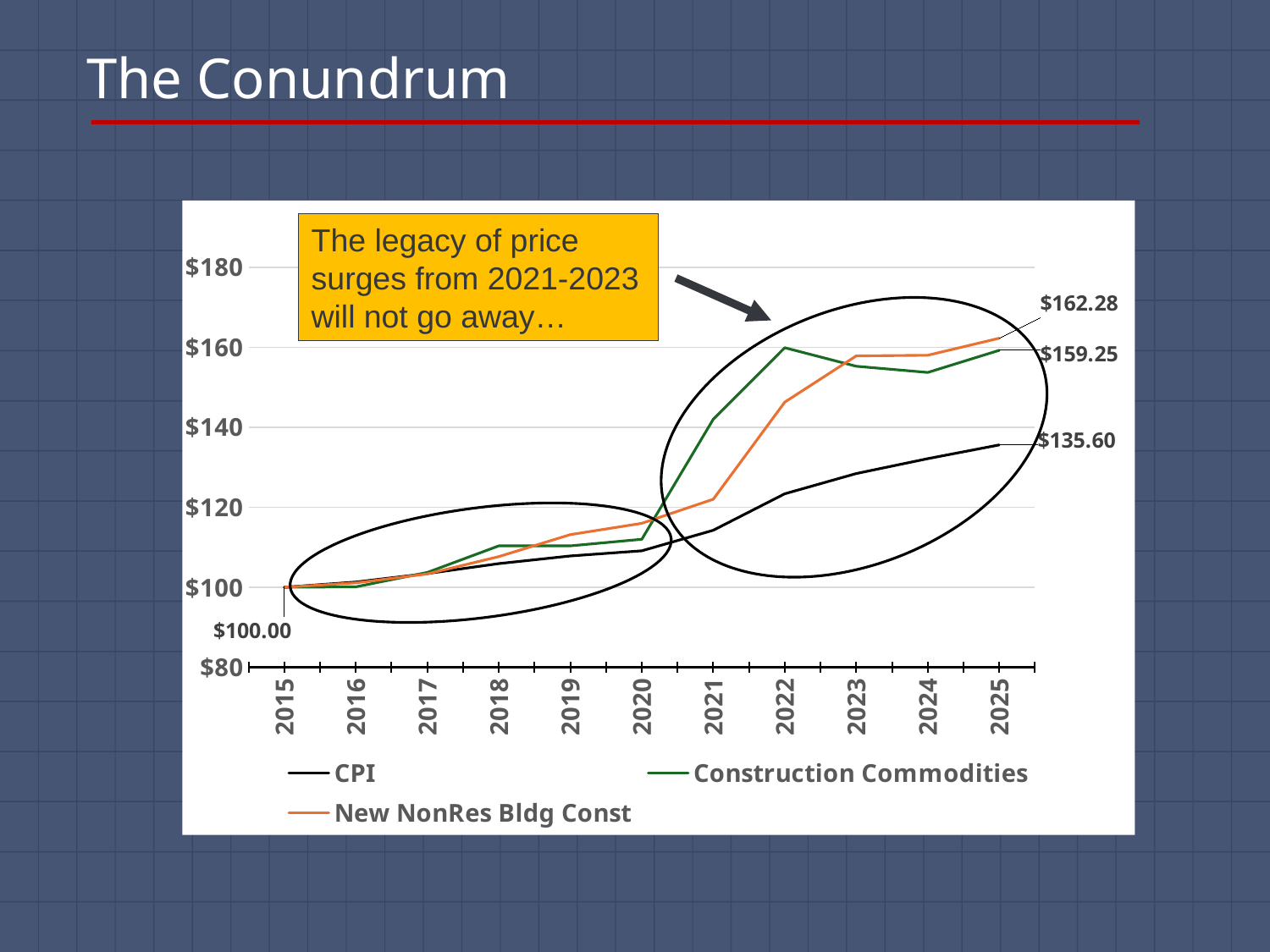
What type of chart is shown on the slide? line chart What is the starting value of the series in 2015? $100.00 What is the value of Construction Commodities in 2025? $159.25 What is the value of CPI in 2025? $135.60 What is the value of New NonRes Bldg Const in 2025? $162.28 How many years are shown along the x axis? 11 Which series has the lowest value in 2025? CPI Is the value for Construction Commodities in 2022 greater or less than $140? greater Which series has the highest value in 2025? New NonRes Bldg Const What is the difference between the 2025 values of New NonRes Bldg Const and CPI? $26.68 Does the CPI line rise or fall from 2015 to 2025? rise How many series does the legend list? 3